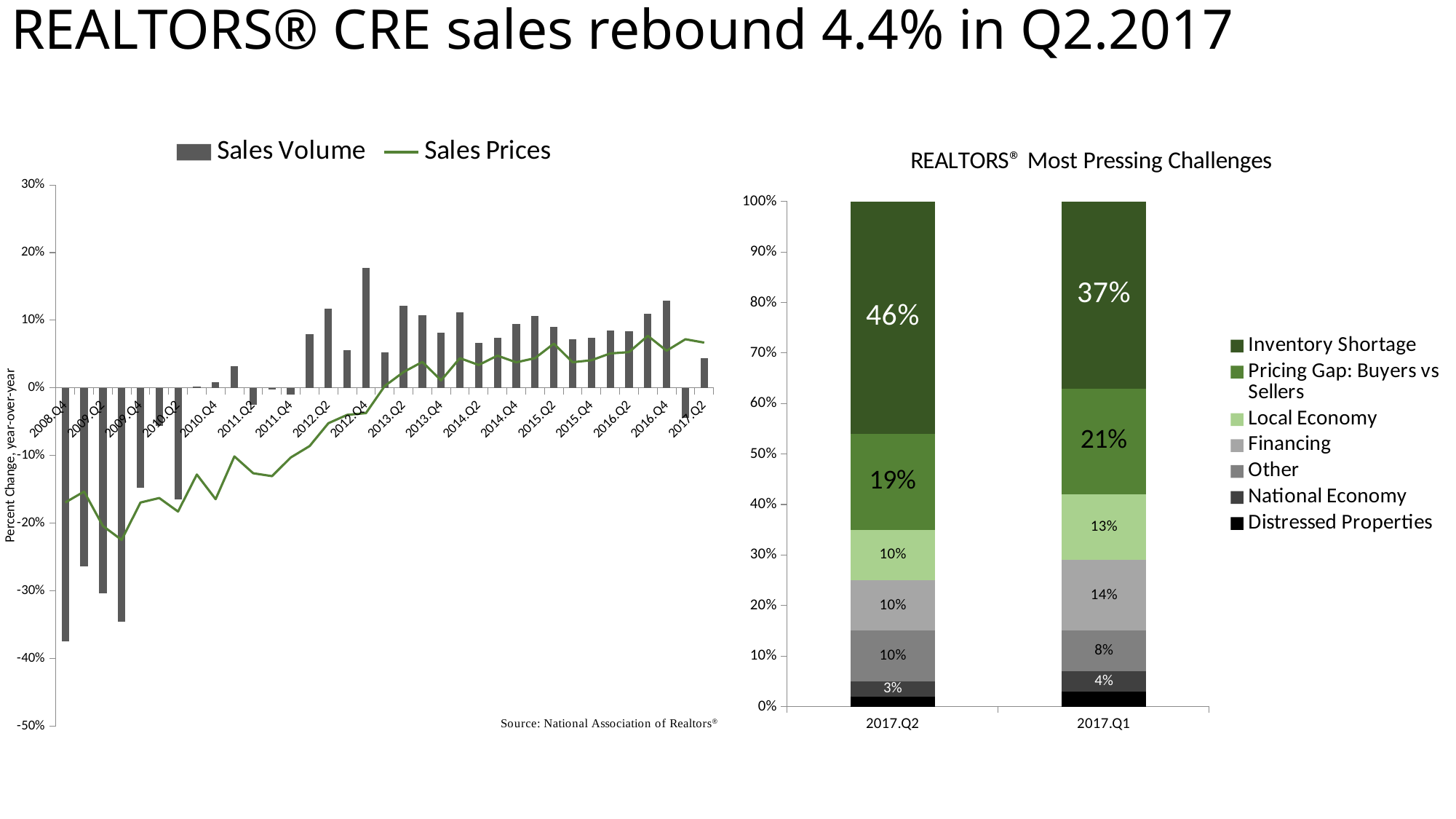
In the left chart, is the Sales Volume value for 2008.Q4 greater or less than -30%? less In the REALTORS Most Pressing Challenges chart, which challenge has the largest share in 2017.Q1? Inventory Shortage In the REALTORS Most Pressing Challenges chart, what is the Financing value for 2017.Q1? 14% In the REALTORS Most Pressing Challenges chart, what share of the 2017.Q2 bar is Inventory Shortage? 46% In the REALTORS Most Pressing Challenges chart, what is the National Economy value for 2017.Q2? 3% In the left chart, is the Sales Volume value for 2012.Q4 greater or less than 10%? greater In the left chart, does the Sales Prices line generally rise or fall from 2008.Q4 to 2017.Q2? rise In the REALTORS Most Pressing Challenges chart, what is the Pricing Gap: Buyers vs Sellers value for 2017.Q1? 21% How many series does the legend of the REALTORS Most Pressing Challenges chart list? 7 How many series does the legend of the left chart (Sales Volume / Sales Prices) list? 2 In the REALTORS Most Pressing Challenges chart, by how many percentage points did Inventory Shortage change from 2017.Q1 to 2017.Q2? 9 percentage points In the REALTORS Most Pressing Challenges chart, is Local Economy larger in 2017.Q2 or 2017.Q1? 2017.Q1